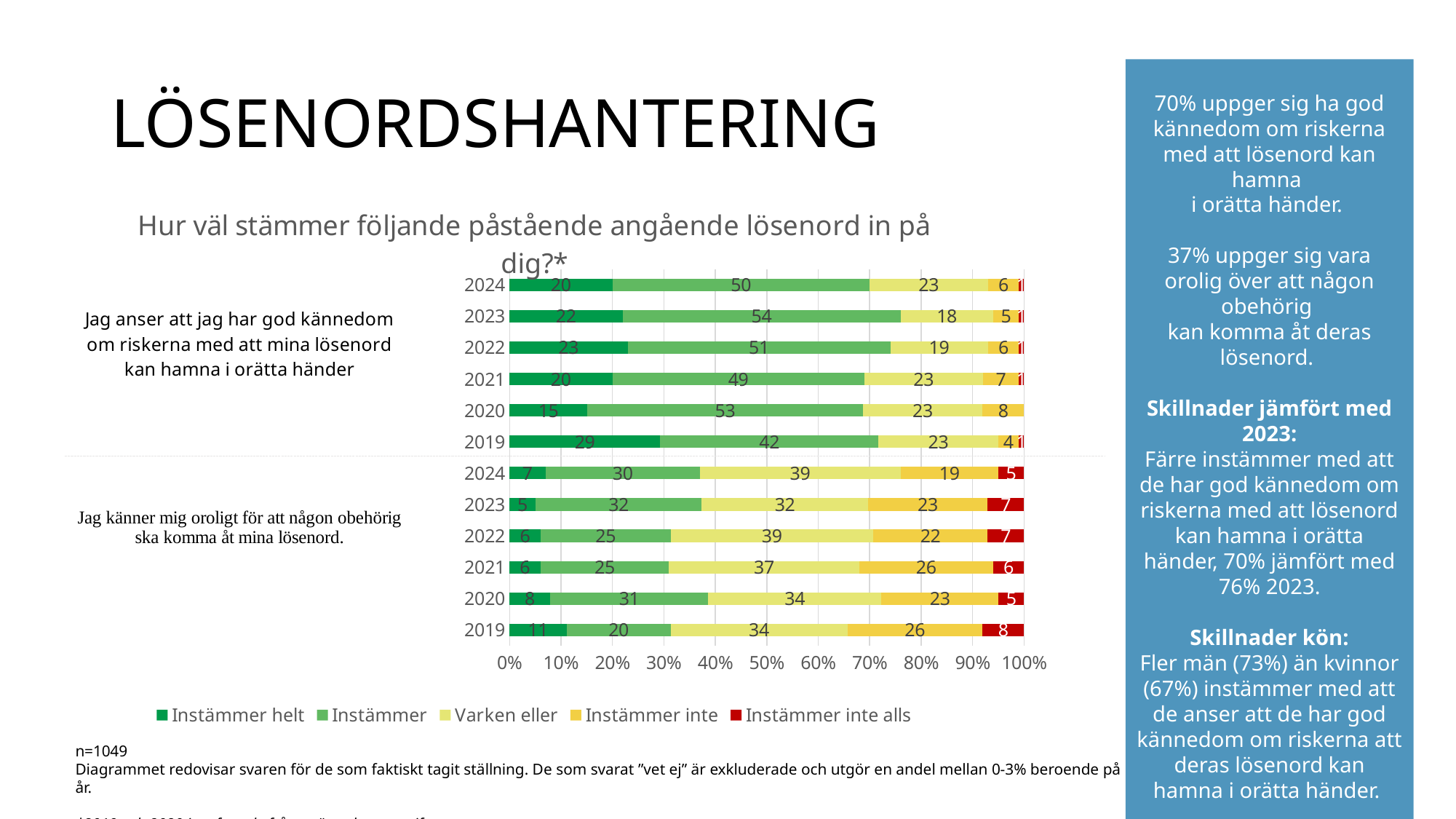
For the statement "Jag känner mig oroligt för att någon obehörig ska komma åt mina lösenord", what is the "Instämmer inte alls" value for 2019? 8 What is the first entry in the chart legend? Instämmer helt For the statement "Jag anser att jag har god kännedom...", which year has the lowest "Instämmer helt" value? 2020 For the statement "Jag anser att jag har god kännedom...", what is the difference between the "Instämmer" values for 2023 and 2024? 4 For the statement "Jag känner mig oroligt...", what is the "Instämmer inte" value for 2021? 26 What kind of chart is shown on the slide? Stacked bar chart For the statement "Jag anser att jag har god kännedom...", which year has the highest "Instämmer helt" value? 2019 How many series does the chart legend list? 5 How many years are shown for each statement in the chart? 6 For the statement "Jag känner mig oroligt...", which year has the larger "Varken eller" value, 2024 or 2023? 2024 For the statement "Jag känner mig oroligt...", what is the total of the 2024 stacked bar (7 + 30 + 39 + 19 + 5)? 100 For the statement "Jag anser att jag har god kännedom om riskerna med att mina lösenord kan hamna i orätta händer", what is the "Instämmer" value for 2023? 54